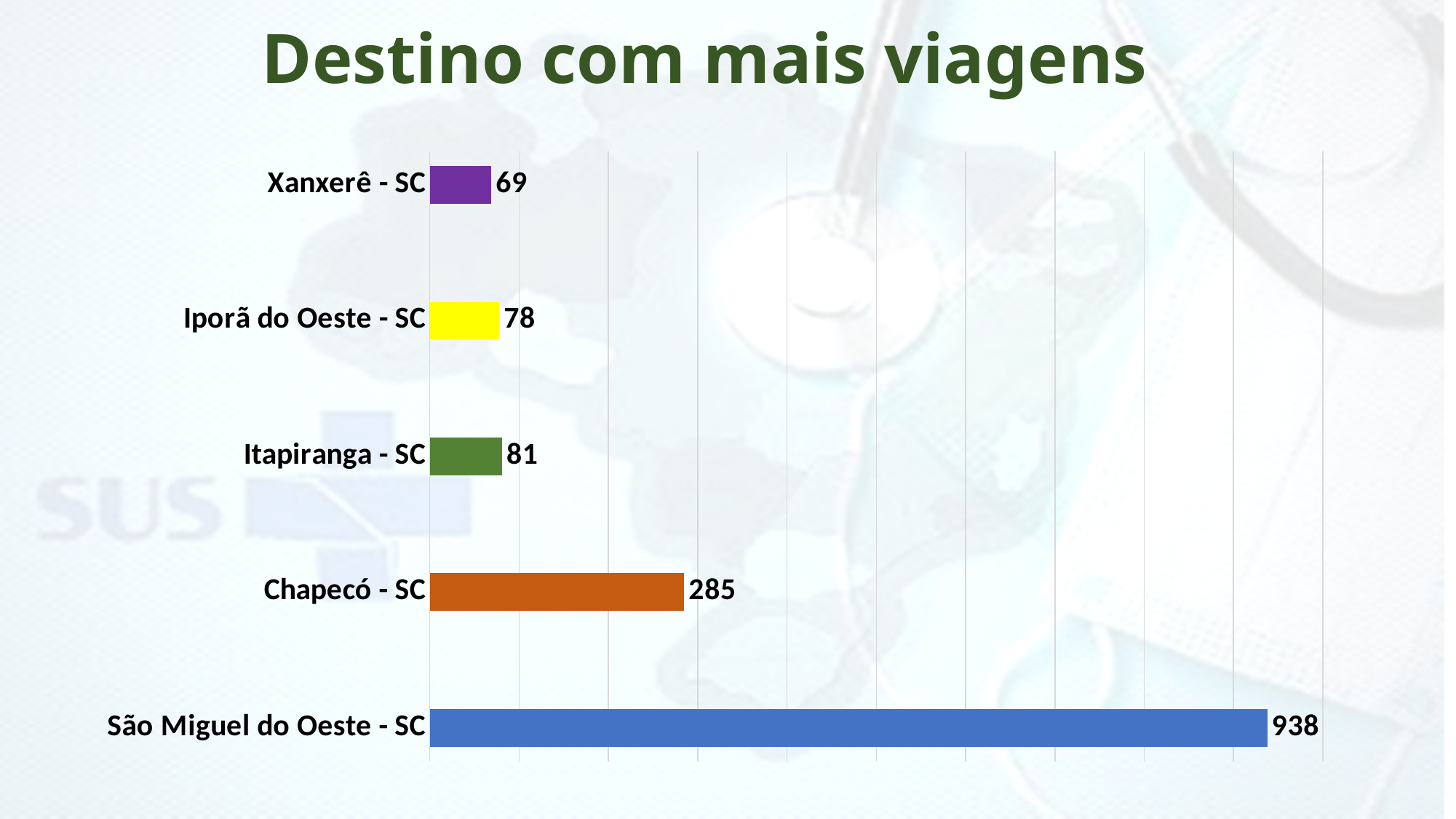
Which destination has the highest value? São Miguel do Oeste - SC What is the difference between the values for São Miguel do Oeste - SC and Chapecó - SC? 653 What is the value for Itapiranga - SC? 81 What is the value for Xanxerê - SC? 69 Which is larger, the value for Chapecó - SC or the value for Itapiranga - SC? Chapecó - SC What is the value for Iporã do Oeste - SC? 78 What is the value for Chapecó - SC? 285 How many destinations are shown in the chart? 5 Which destination has the lowest value? Xanxerê - SC What kind of chart is shown on the slide? Bar chart What is the value for São Miguel do Oeste - SC? 938 What is the difference between the values for Itapiranga - SC and Xanxerê - SC? 12